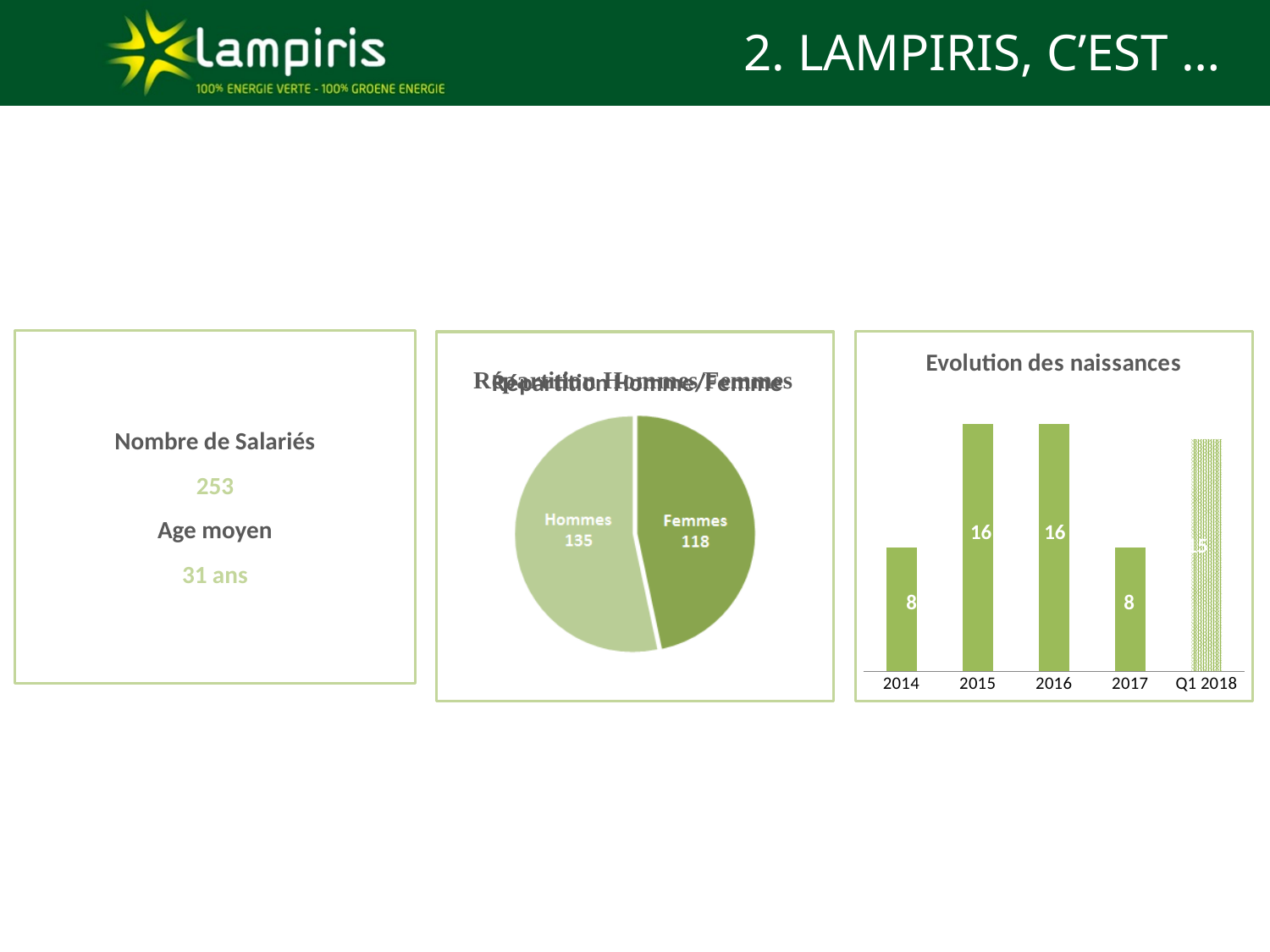
How many categories are shown on the x axis of the chart 'Evolution des naissances'? 5 In the chart 'Evolution des naissances', which years have the highest value? 2015 and 2016 In the pie chart 'Répartition Hommes/Femmes', what is the value for Hommes? 135 In the chart 'Evolution des naissances', what is the value for 2017? 8 In the pie chart 'Répartition Hommes/Femmes', which slice is larger, Hommes or Femmes? Hommes How many slices does the pie chart 'Répartition Hommes/Femmes' have? 2 In the chart 'Evolution des naissances', what is the value for 2015? 16 In the pie chart 'Répartition Hommes/Femmes', what is the difference between the Hommes and Femmes values? 17 In the chart 'Evolution des naissances', what is the value for 2014? 8 What kind of chart is 'Evolution des naissances'? Bar chart In the pie chart 'Répartition Hommes/Femmes', what is the value for Femmes? 118 In the chart 'Evolution des naissances', what is the difference between the values for 2015 and 2014? 8